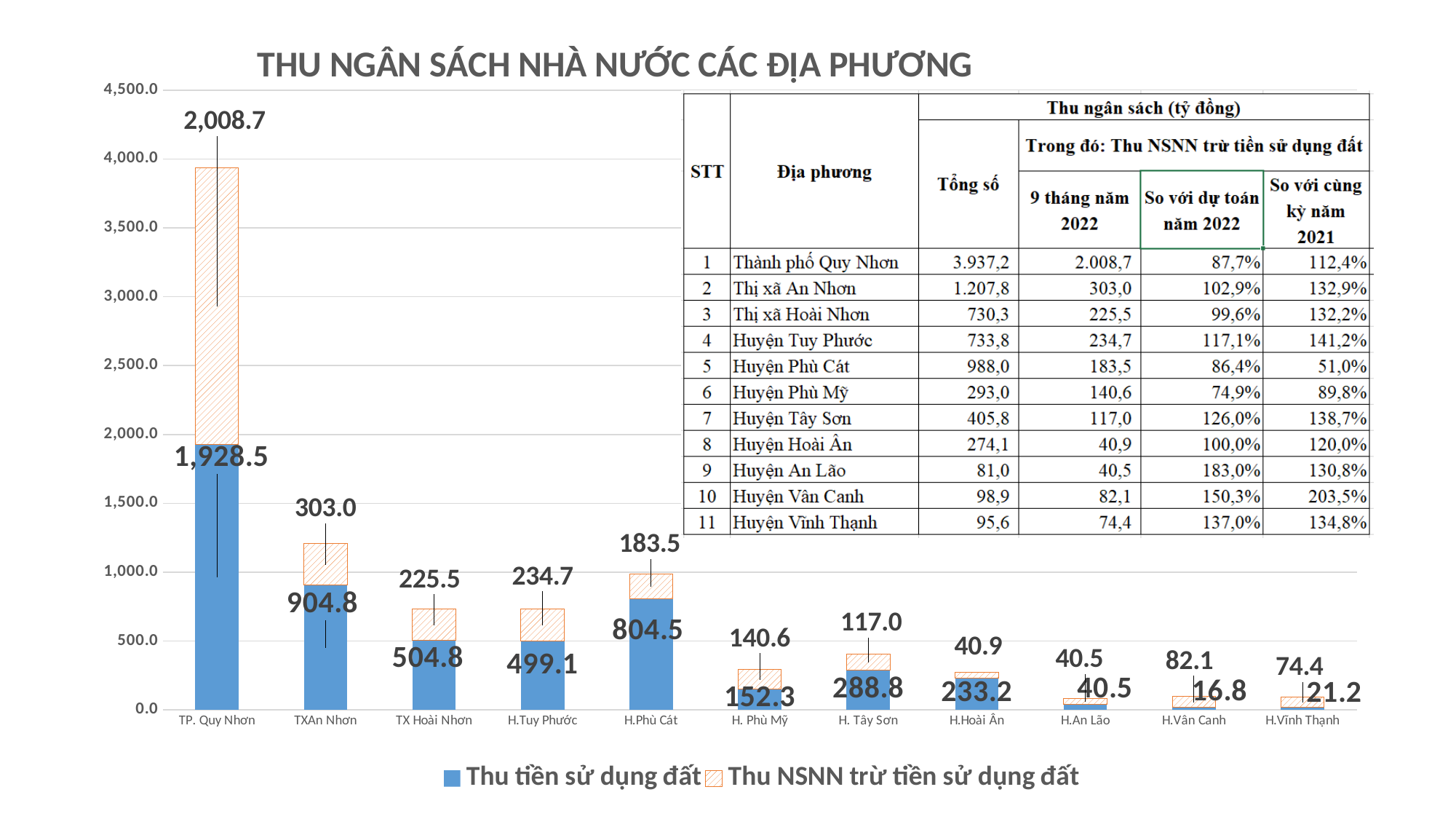
What is the difference between the Thu tiền sử dụng đất values for H.Phù Cát and H.Tuy Phước? 305.4 Which locality has the highest value of Thu tiền sử dụng đất? TP. Quy Nhơn Which locality has the lowest value of Thu tiền sử dụng đất? H.Vân Canh What is the difference between the Thu NSNN trừ tiền sử dụng đất values for TP. Quy Nhơn and TXAn Nhơn? 1,705.7 For H.Vân Canh, which is larger: Thu tiền sử dụng đất or Thu NSNN trừ tiền sử dụng đất? Thu NSNN trừ tiền sử dụng đất What type of chart is shown on the slide? Stacked bar chart What is the total of the stacked bar for TP. Quy Nhơn? 3,937.2 What is the value of Thu tiền sử dụng đất for TP. Quy Nhơn? 1,928.5 How many localities are shown on the x axis of the chart? 11 What is the value of Thu tiền sử dụng đất for H.Vân Canh? 16.8 What is the value of Thu NSNN trừ tiền sử dụng đất for H.Phù Cát? 183.5 How many series does the chart legend list? 2